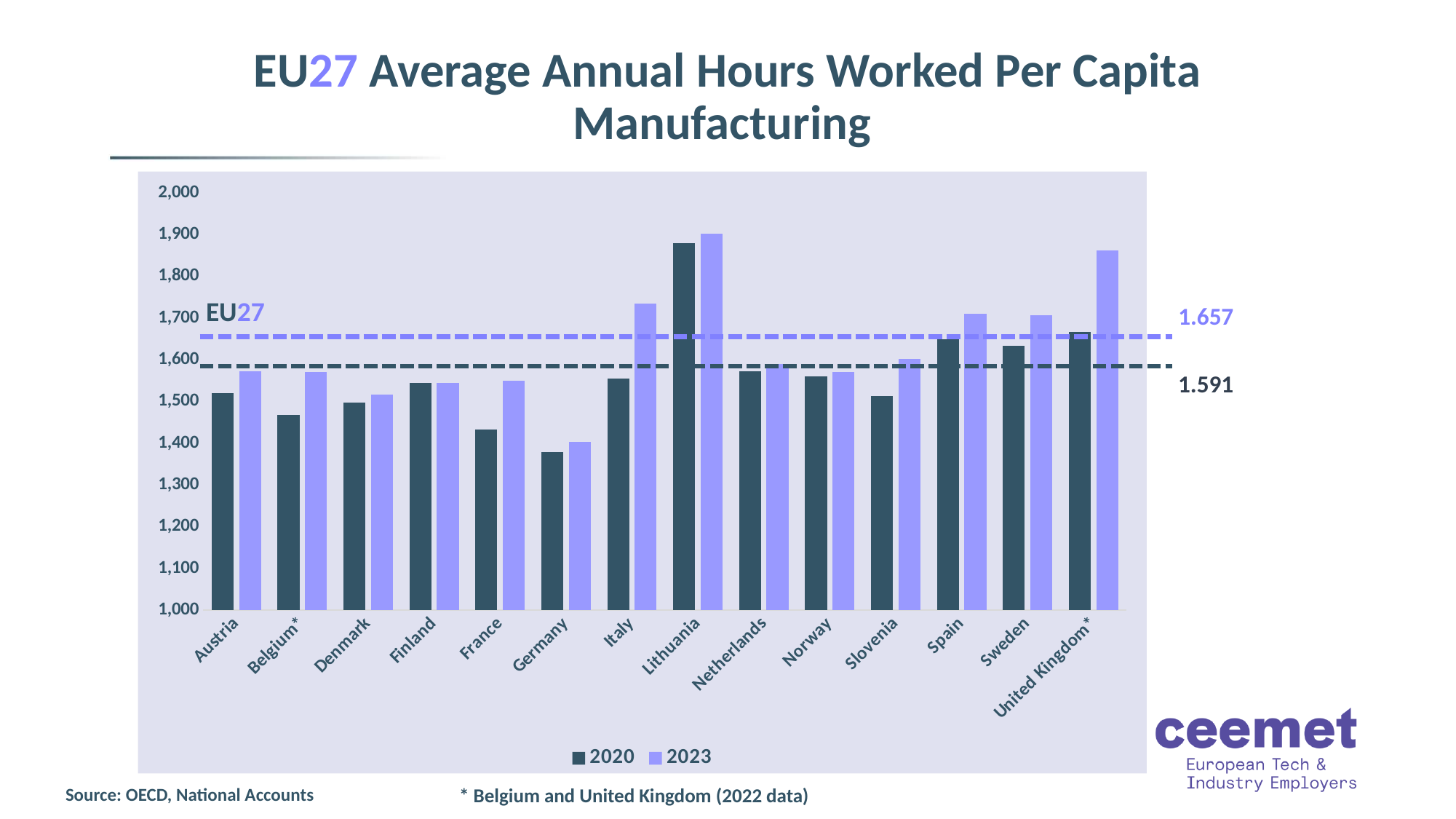
Is the 2020 value for France greater or less than 1,500? less How many series does the legend list? 2 What is the difference between the two EU27 reference line values, 1.657 and 1.591? 0.066 Is the 2023 value for United Kingdom greater or less than 1,800? greater What value is labelled on the purple dashed EU27 reference line? 1.657 Which country has the highest 2023 bar? Lithuania What is the title of the chart? EU27 Average Annual Hours Worked Per Capita Manufacturing Which country has the lowest 2020 bar? Germany What value is labelled on the dark dashed EU27 reference line? 1.591 Which is larger, the 2023 value for Austria or the 2023 value for Germany? Austria How many countries are shown on the x axis? 14 What kind of chart is shown on the slide? bar chart